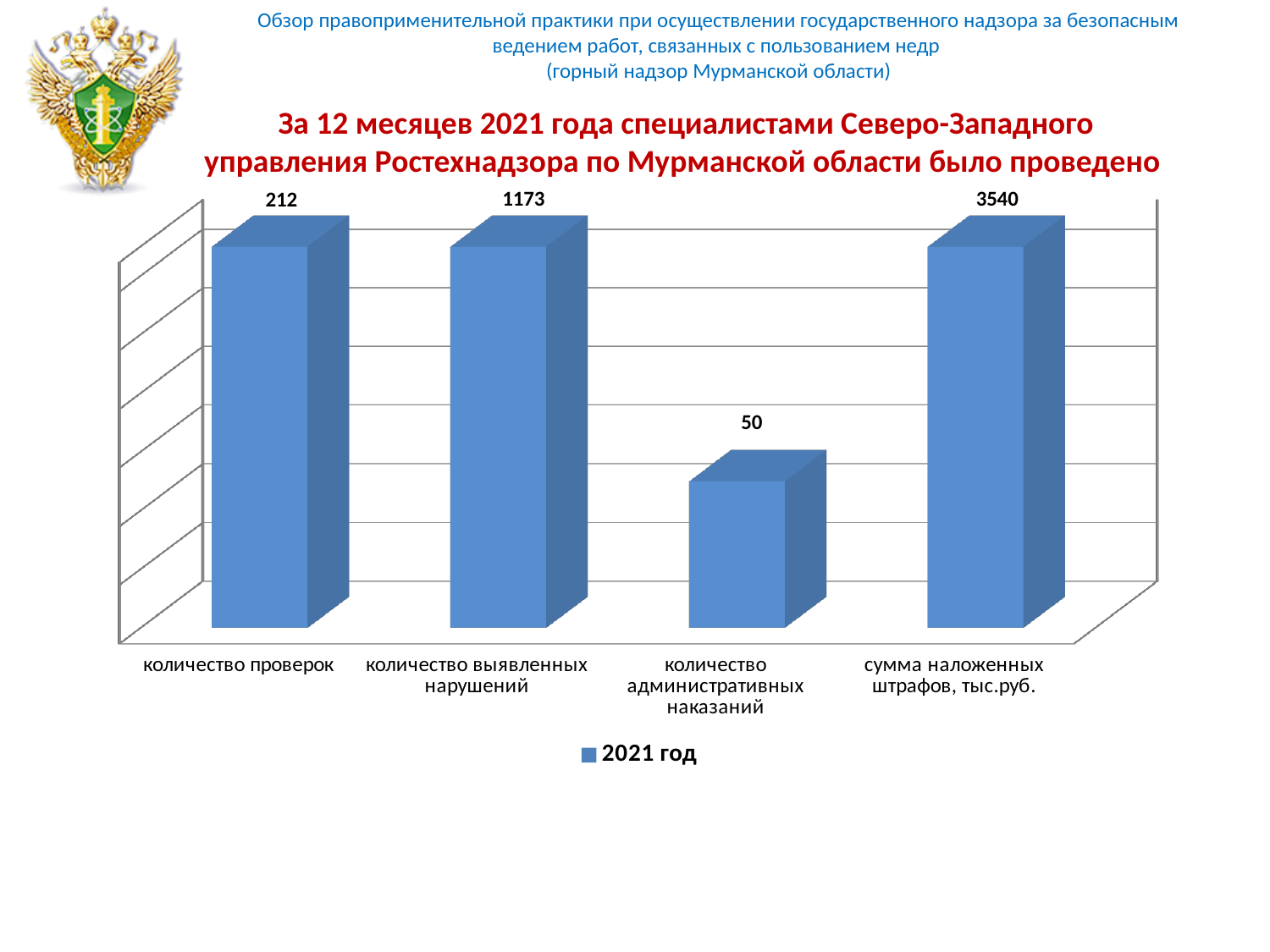
What is the difference between количество выявленных нарушений and количество проверок? 961 What is the value for количество проверок? 212 What kind of chart is shown on the slide? bar chart Which category has the lowest value? количество административных наказаний What is the value for сумма наложенных штрафов, тыс.руб.? 3540 How many series does the legend list? 1 What is the value for количество административных наказаний? 50 What is the difference between количество проверок and количество административных наказаний? 162 How many categories are shown on the chart? 4 Which category has the highest labelled value? сумма наложенных штрафов, тыс.руб. What is the value for количество выявленных нарушений? 1173 Which is larger: количество выявленных нарушений or количество проверок? количество выявленных нарушений